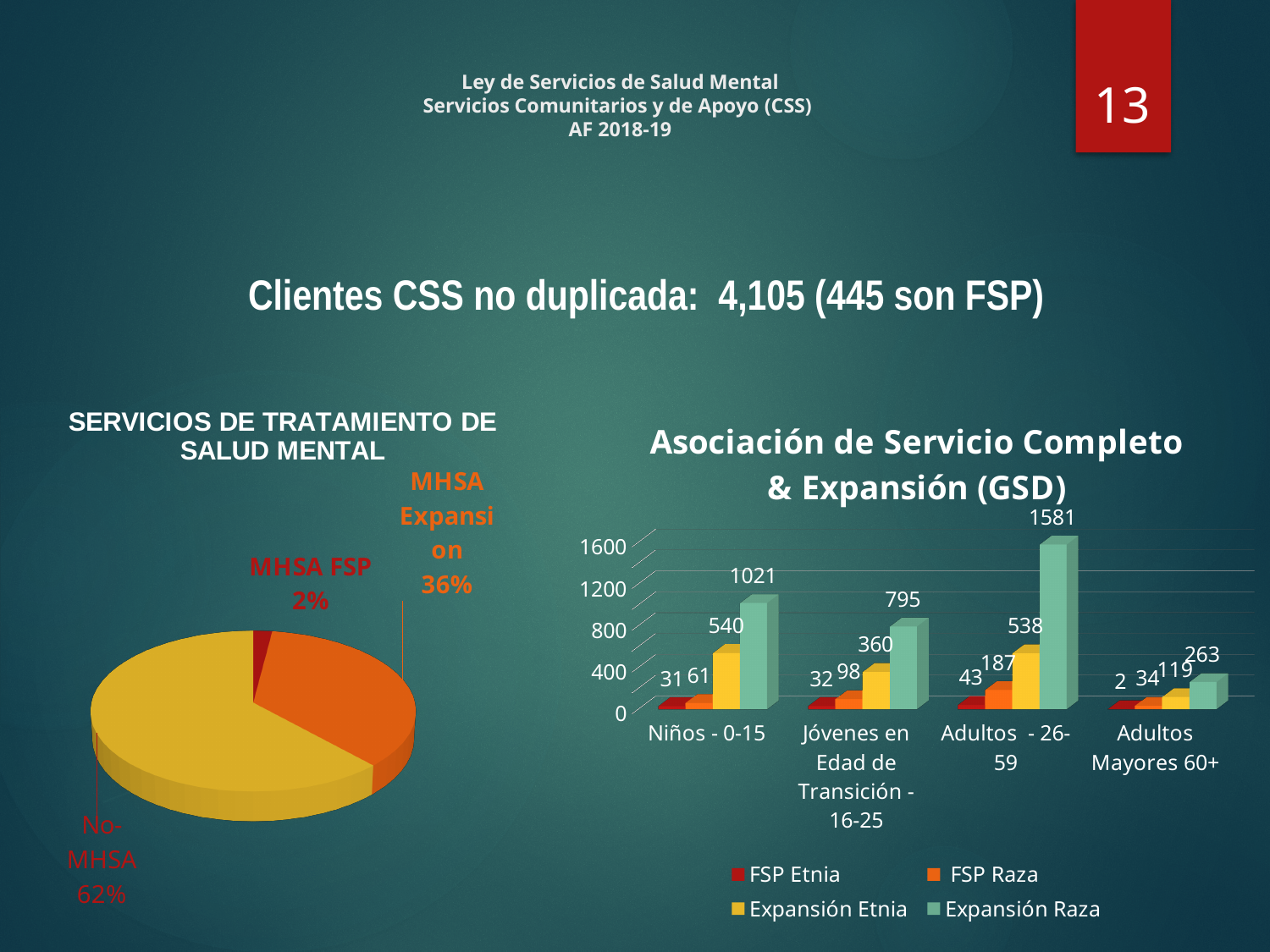
In the bar chart 'Asociación de Servicio Completo & Expansión (GSD)', what is the value of Expansión Etnia for Niños - 0-15? 540 In the bar chart 'Asociación de Servicio Completo & Expansión (GSD)', what is the value of FSP Raza for Jóvenes en Edad de Transición - 16-25? 98 In the pie chart 'SERVICIOS DE TRATAMIENTO DE SALUD MENTAL', what share does MHSA Expansion have? 36% In the bar chart 'Asociación de Servicio Completo & Expansión (GSD)', what is the value of Expansión Raza for Adultos - 26-59? 1581 How many series does the legend of the bar chart 'Asociación de Servicio Completo & Expansión (GSD)' list? 4 In the bar chart 'Asociación de Servicio Completo & Expansión (GSD)', which is larger: Expansión Etnia for Jóvenes en Edad de Transición - 16-25 or Expansión Etnia for Adultos - 26-59? Adultos - 26-59 How many categories are shown on the x axis of the bar chart 'Asociación de Servicio Completo & Expansión (GSD)'? 4 In the bar chart 'Asociación de Servicio Completo & Expansión (GSD)', which category has the highest Expansión Raza value? Adultos - 26-59 What kind of chart is 'SERVICIOS DE TRATAMIENTO DE SALUD MENTAL'? Pie chart In the bar chart 'Asociación de Servicio Completo & Expansión (GSD)', what is the difference between the Expansión Raza values for Adultos - 26-59 and Niños - 0-15? 560 In the pie chart 'SERVICIOS DE TRATAMIENTO DE SALUD MENTAL', which slice is the largest? No-MHSA In the bar chart 'Asociación de Servicio Completo & Expansión (GSD)', which category has the lowest FSP Etnia value? Adultos Mayores 60+